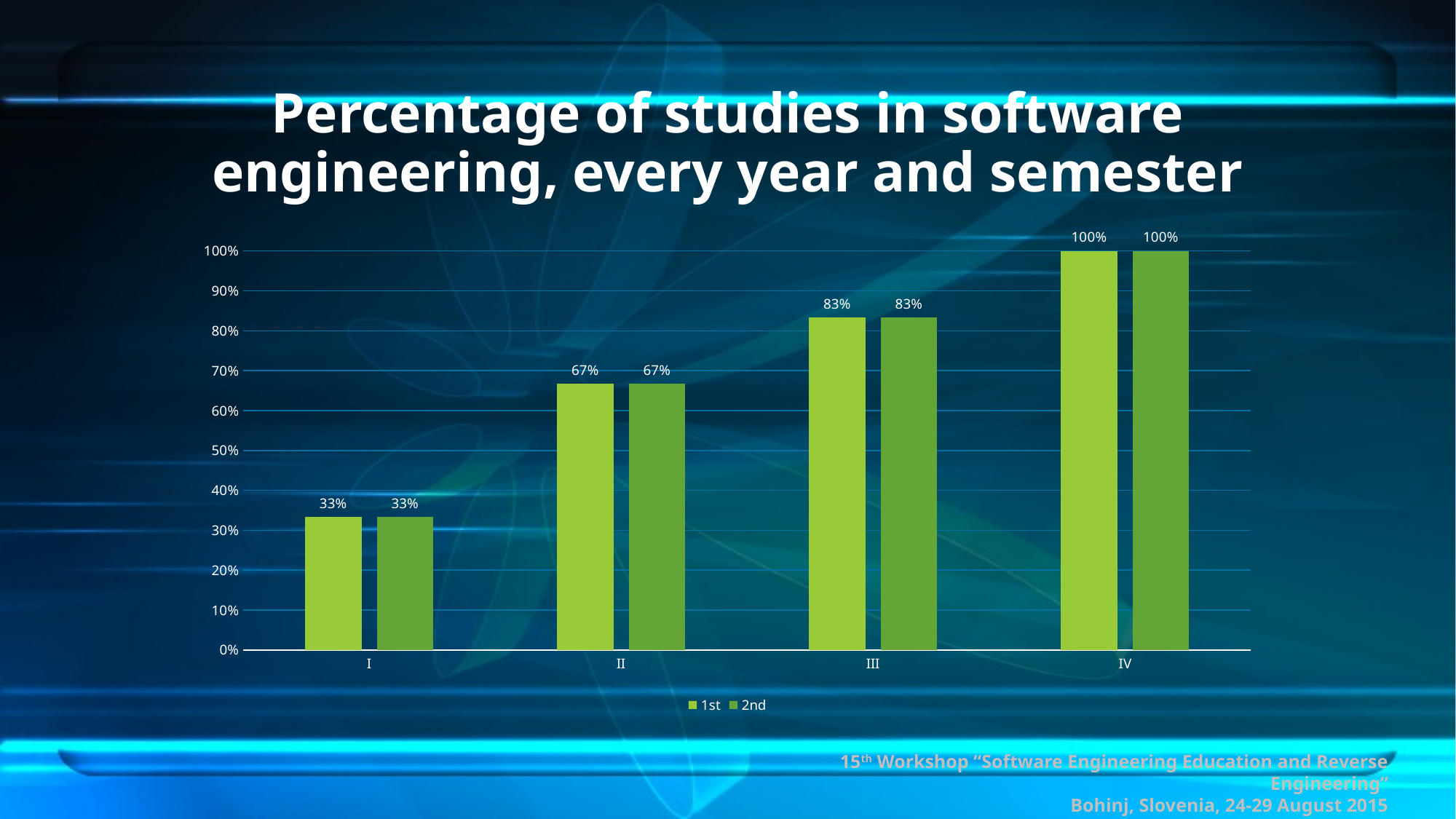
What is the value for the 1st semester in year II? 67% How many series does the legend list? 2 Is the value for the 1st semester in year III greater or less than 80%? greater Which year has the highest value for the 1st semester? IV What is the value for the 2nd semester in year III? 83% Which year has the lowest value for the 2nd semester? I What is the value for the 1st semester in year I? 33% What is the difference between the 1st semester values for year IV and year I? 67% How many years (categories) are shown on the x axis? 4 Do the 1st semester values rise or fall from year I to year IV? rise Which is larger: the 2nd semester value for year II or for year III? year III What kind of chart is shown on the slide? bar chart